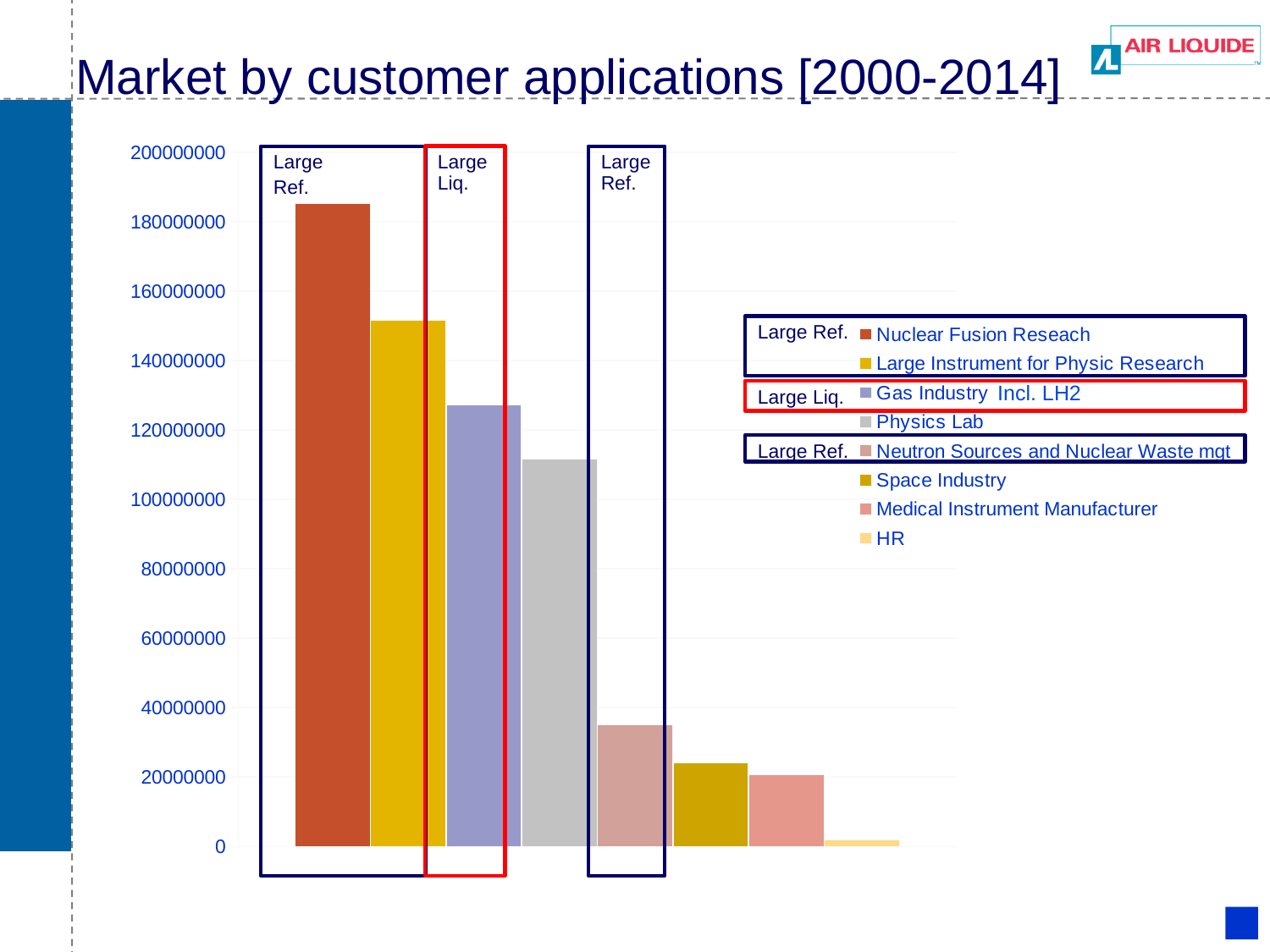
Is the value for Large Instrument for Physic Research greater or less than 140000000? greater Which customer application has the lowest value? HR What is the title of the chart? Market by customer applications [2000-2014] Is the value for Nuclear Fusion Reseach greater or less than 180000000? greater Is the value for Gas Industry Incl. LH2 greater or less than 120000000? greater Which is larger, the value for Physics Lab or the value for Space Industry? Physics Lab Which is larger, the value for Gas Industry Incl. LH2 or the value for Physics Lab? Gas Industry Incl. LH2 How many bars are plotted in the chart? 8 What kind of chart is shown on the slide? bar chart How many series does the legend list? 8 Which customer application has the highest value? Nuclear Fusion Reseach